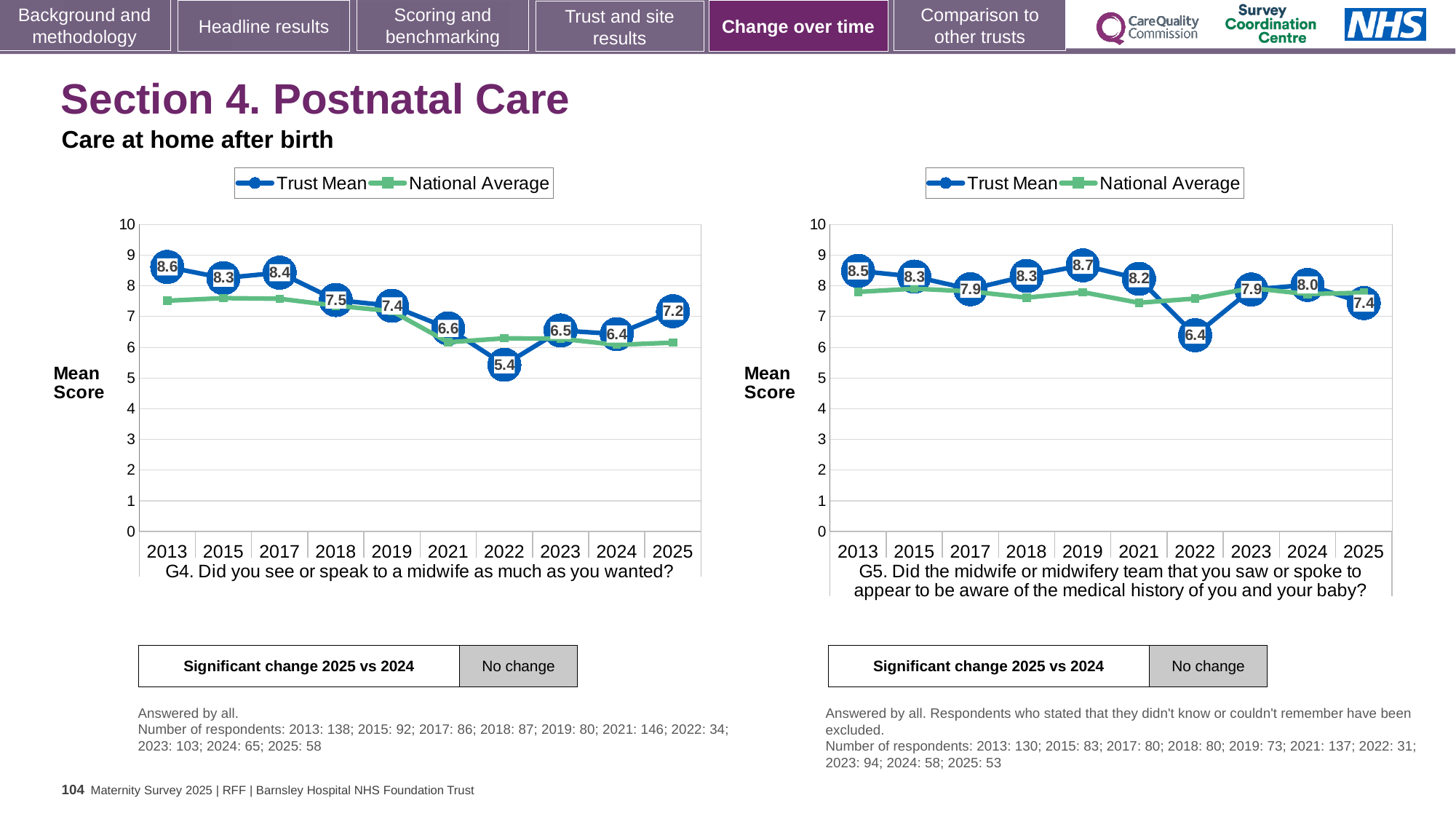
On the G5 chart, what is the Trust Mean score for 2019? 8.7 What type of chart is the G4 chart? Line chart How many series does the legend of the G5 chart list? 2 On the G4 chart, does the Trust Mean rise or fall between 2013 and 2022? Fall On the G4 chart, which year has the highest Trust Mean score? 2013 On the G4 chart, which year has the lowest Trust Mean score? 2022 On the G5 chart, which year has the lowest Trust Mean score? 2022 On the G4 chart, what is the difference between the Trust Mean scores for 2013 and 2025? 1.4 On the G5 chart, is the National Average value for 2022 greater or less than 7? greater How many years are plotted on the x axis of the G4 chart? 10 On the G4 chart, what is the Trust Mean score for 2022? 5.4 On the G5 chart, is the Trust Mean score higher in 2024 or in 2025? 2024